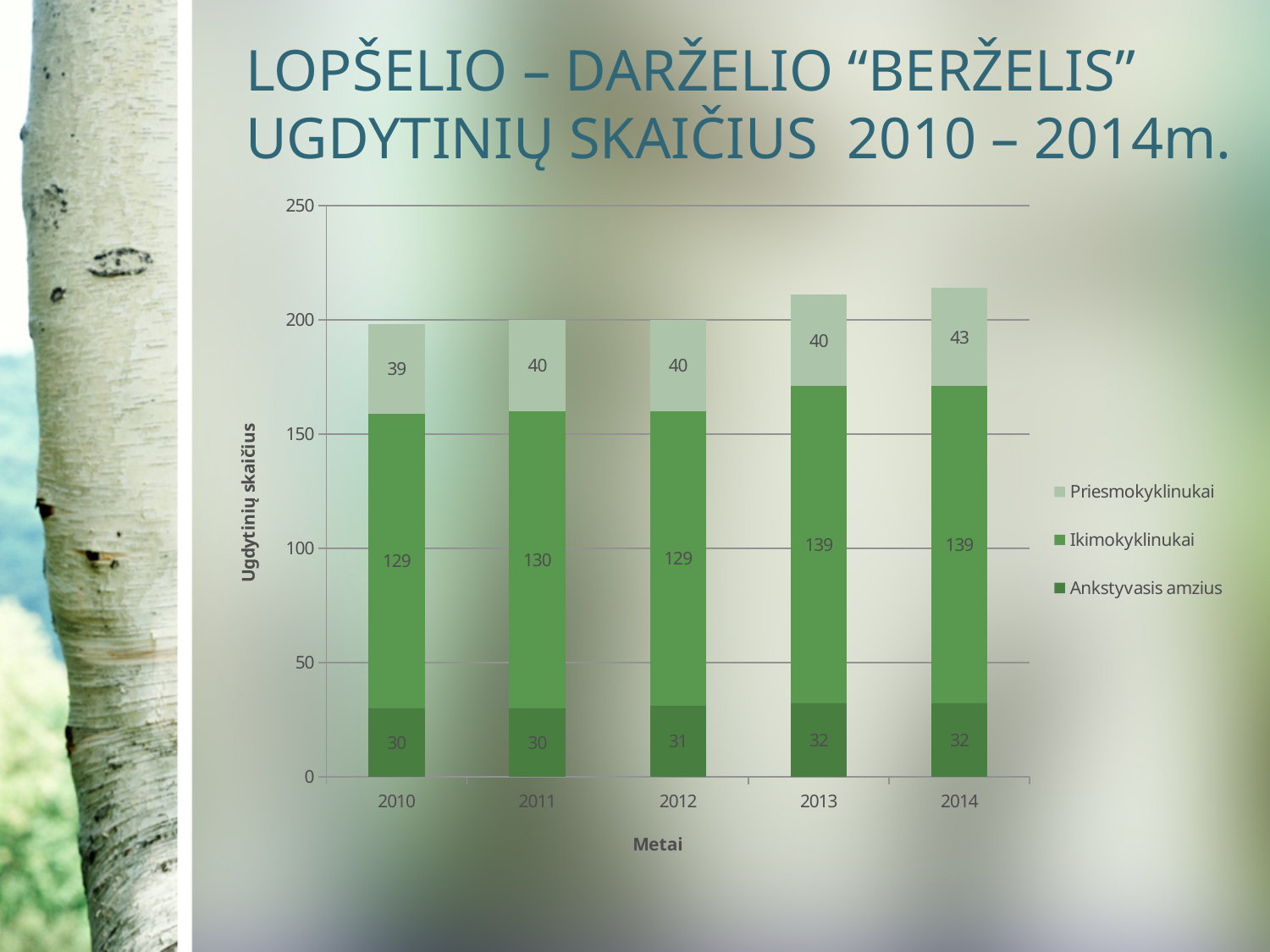
What is the value for Priesmokyklinukai in 2014? 43 How many series does the legend list? 3 What is the total of the stacked bar for 2010? 198 What kind of chart is shown on the slide? Stacked bar chart What is the difference between the Ikimokyklinukai values in 2013 and 2010? 10 In which year is the Priesmokyklinukai value highest? 2014 Which is larger, the Ankstyvasis amzius value in 2013 or in 2010? 2013 How many years are shown on the x axis? 5 In which year is the Priesmokyklinukai value lowest? 2010 What is the value for Ikimokyklinukai in 2011? 130 What is the total of the stacked bar for 2014? 214 What is the value for Ankstyvasis amzius in 2012? 31